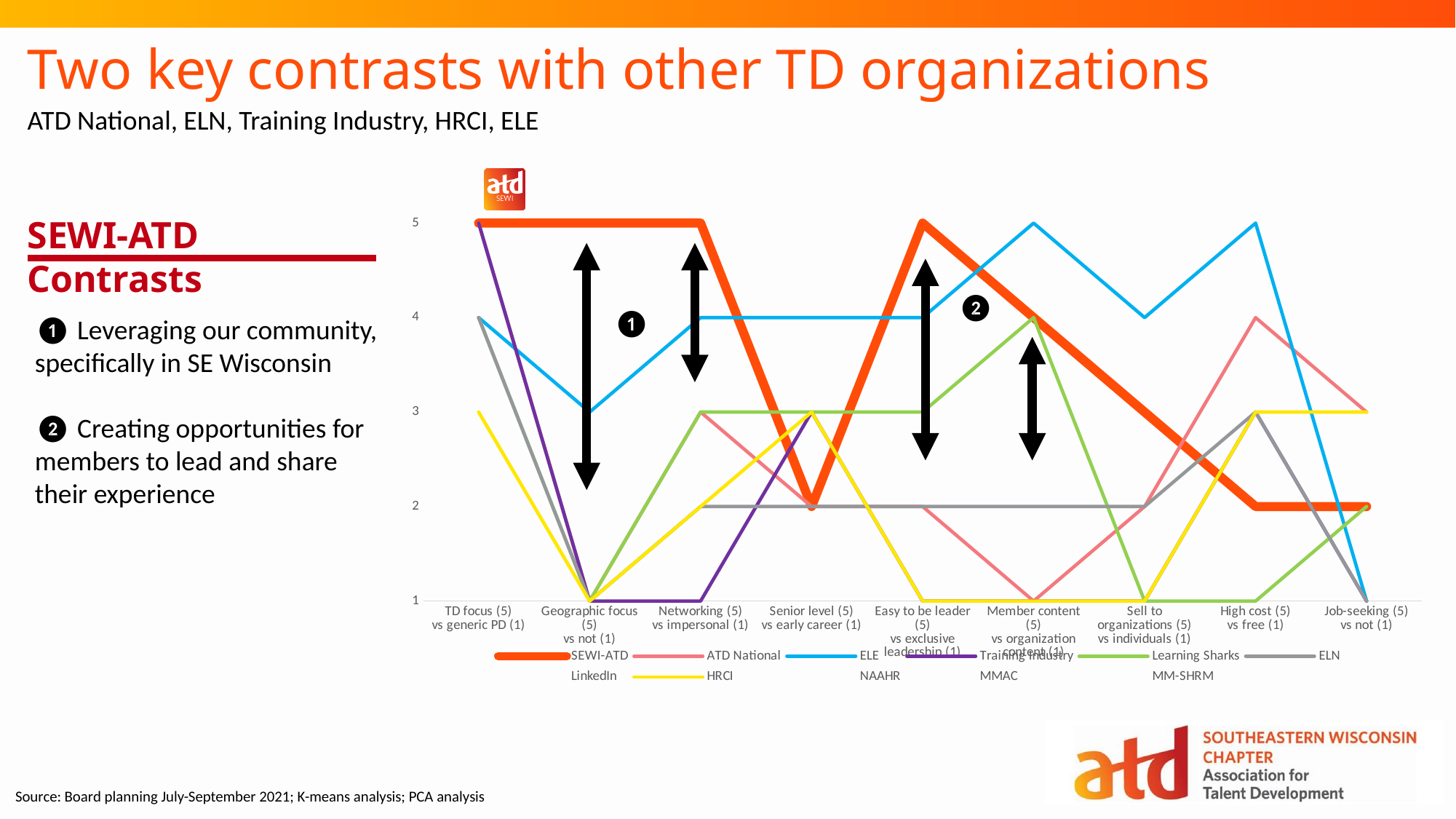
How many series does the chart legend list? 11 At 'Geographic focus (5) vs not (1)', which is larger, SEWI-ATD or ELE? SEWI-ATD Which series is drawn with the thick orange line? SEWI-ATD What is the value for SEWI-ATD at 'Senior level (5) vs early career (1)'? 2 What kind of chart is shown on the slide? line chart Does the SEWI-ATD line rise or fall from 'Member content' to 'High cost'? fall What is the value for ELE at 'Job-seeking (5) vs not (1)'? 1 How many categories are shown along the x axis of the chart? 9 At 'Geographic focus (5) vs not (1)', what is the difference between SEWI-ATD and ELE? 2 For the ELE series, which category has the lowest value? Job-seeking (5) vs not (1) What is the value for SEWI-ATD at 'Easy to be leader (5) vs exclusive leadership (1)'? 5 What is the value for ELE at 'Member content (5) vs organization content (1)'? 5